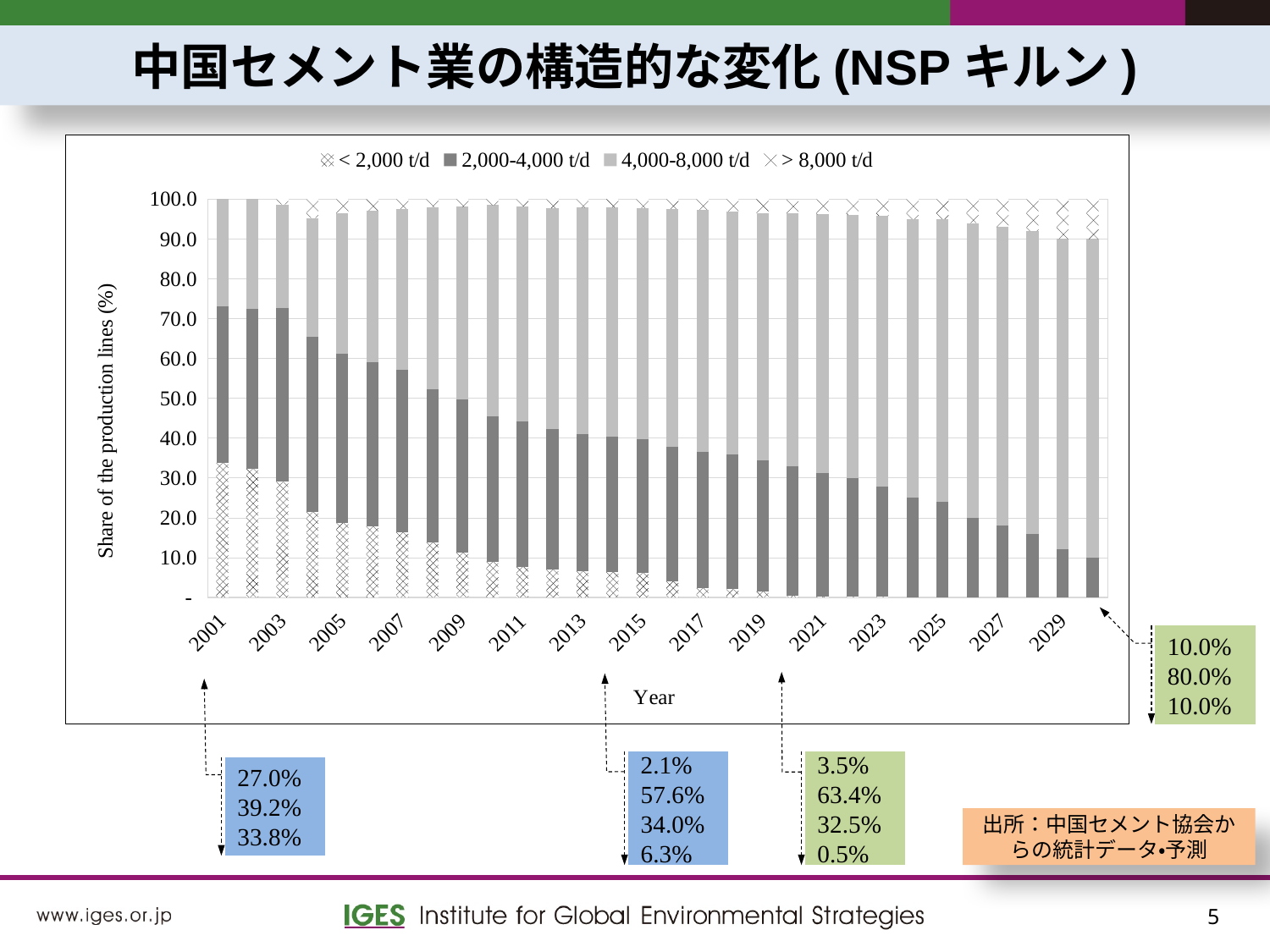
In 2001, which is larger: the 2,000-4,000 t/d share or the 4,000-8,000 t/d share? 2,000-4,000 t/d Does the share of 4,000-8,000 t/d production lines rise or fall from 2001 to 2029? rise What is the label of the vertical axis? Share of the production lines (%) Which year has the highest share of < 2,000 t/d production lines? 2001 Does the share of < 2,000 t/d production lines rise or fall from 2001 to 2029? fall Is the value for 2,000-4,000 t/d in 2029 greater or less than 20.0? less How many series does the legend list? 4 Is the value for > 8,000 t/d in 2029 greater or less than 20.0? less What kind of chart is shown on the slide? Stacked bar chart Is the value for < 2,000 t/d in 2001 greater or less than 30.0? greater What are the four legend entries of the chart? < 2,000 t/d, 2,000-4,000 t/d, 4,000-8,000 t/d, > 8,000 t/d How many stacked bars (years) are plotted in the chart? 30